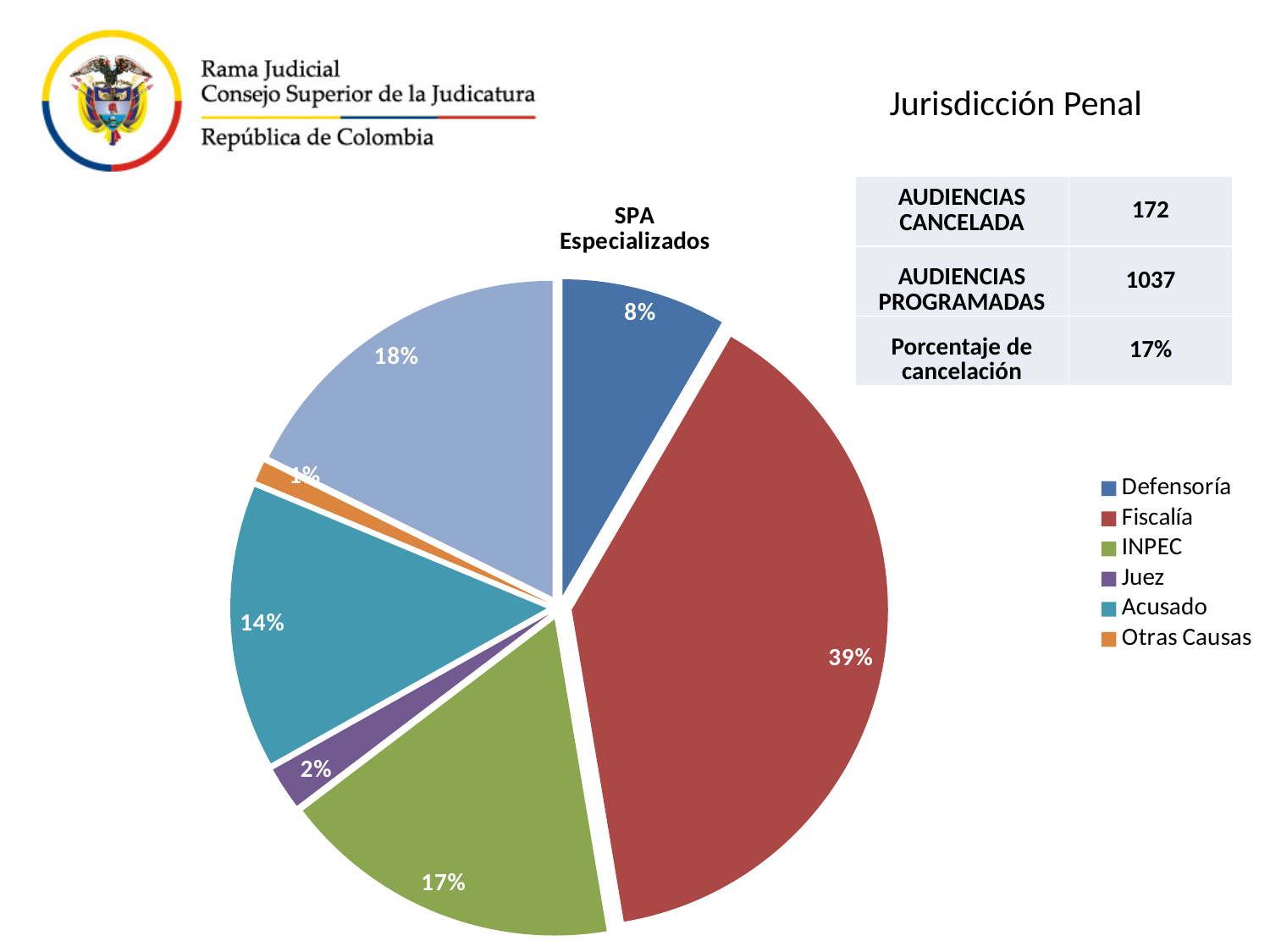
What is the difference in percentage points between Fiscalía and INPEC? 22 percentage points What is the value shown for INPEC? 17% What is the value shown for Defensoría? 8% What kind of chart is shown on the slide? Pie chart What share of the pie does Fiscalía account for? 39% Which category has the largest slice of the pie? Fiscalía How many entries does the legend list? 6 What is the value shown for Acusado? 14% Which category has the smallest slice of the pie? Otras Causas What is the title of the pie chart? SPA Especializados What is the value shown for Juez? 2% What is the value shown for Otras Causas? 1%